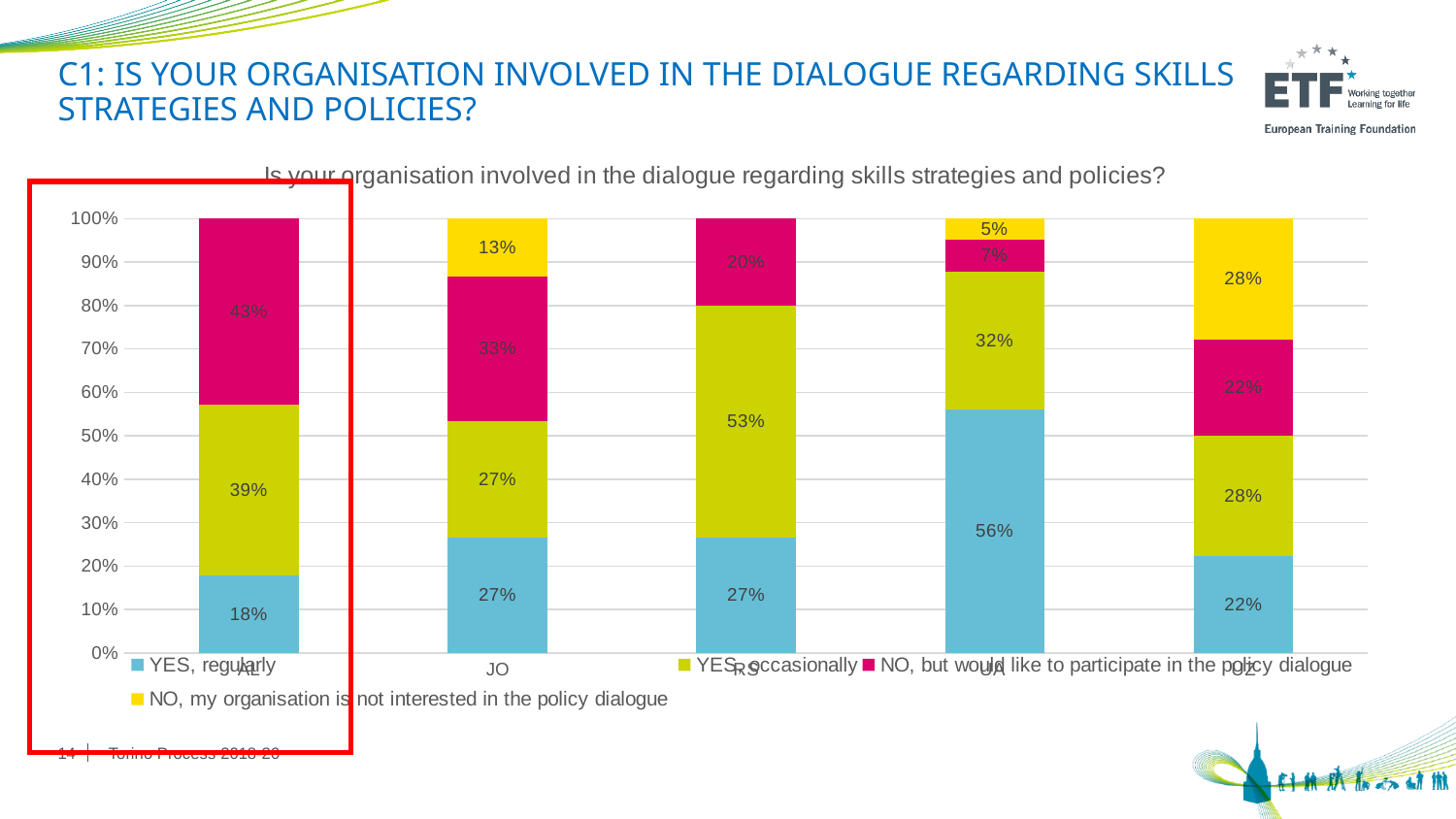
Which country has the highest value for 'YES, regularly'? UA What is the value for 'NO, but would like to participate in the policy dialogue' for AL? 43% What kind of chart is shown on the slide? Stacked bar chart How many series does the legend list? 4 What is the value for 'NO, my organisation is not interested in the policy dialogue' for JO? 13% Which country has the lowest value for 'YES, regularly'? AL What is the value for 'YES, regularly' for UA? 56% What is the difference between the 'YES, regularly' values for UA and AL? 38 percentage points What is the value for 'YES, occasionally' for RS? 53% What is the title of the chart? Is your organisation involved in the dialogue regarding skills strategies and policies? How many countries are shown on the x axis? 5 Which has the larger 'YES, occasionally' value, RS or UA? RS